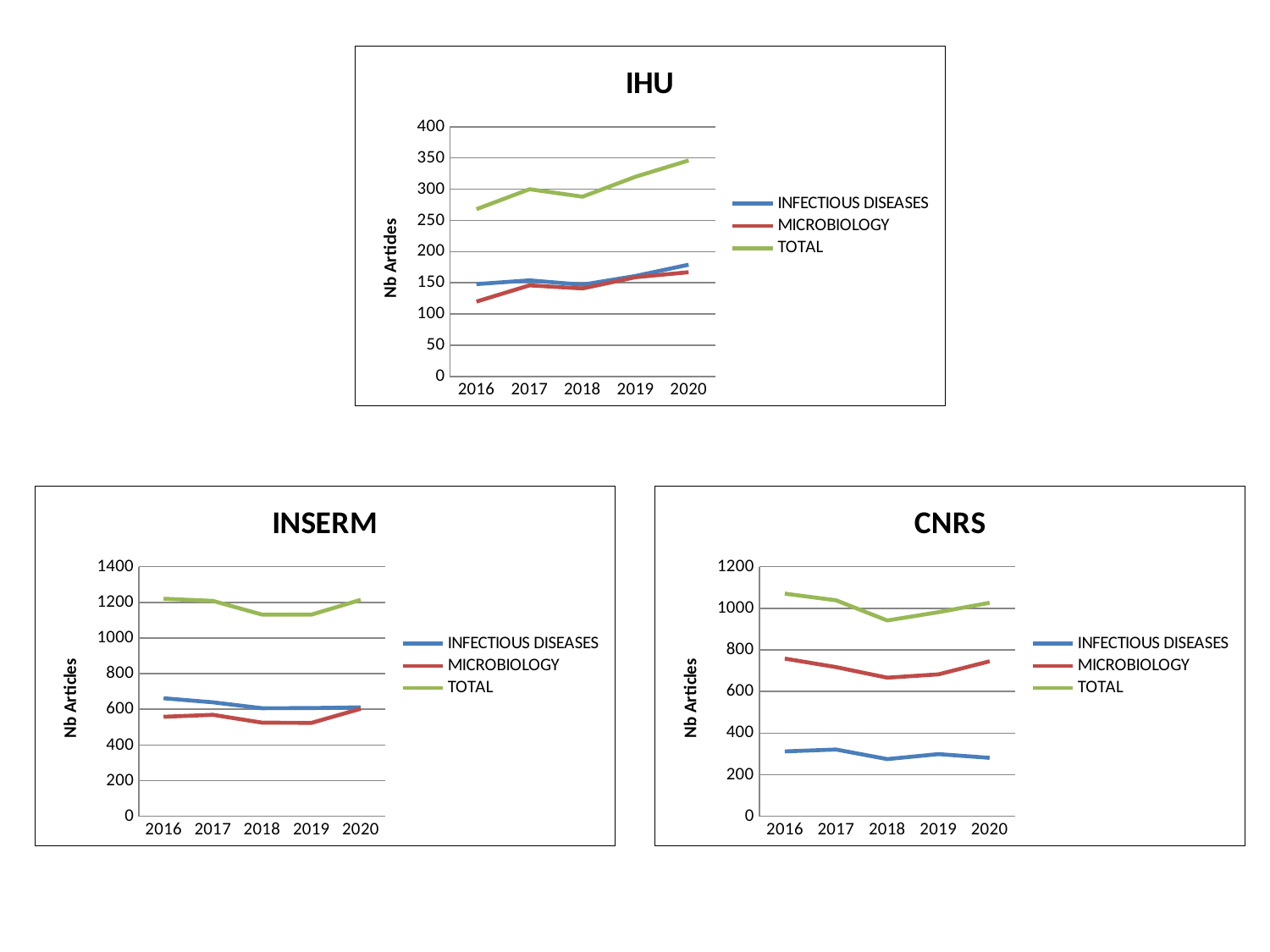
In the CNRS chart, is the TOTAL value for 2018 greater or less than 1000? less In the CNRS chart, which year has the lowest TOTAL value? 2018 In the INSERM chart, which series is larger in 2016, INFECTIOUS DISEASES or MICROBIOLOGY? INFECTIOUS DISEASES In the IHU chart, is the MICROBIOLOGY value for 2016 greater or less than 150? less How many years are plotted on the x axis of the CNRS chart? 5 In the IHU chart, which year has the highest TOTAL value? 2020 In the IHU chart, is the TOTAL value for 2020 greater or less than 300? greater What is the y-axis label of the CNRS chart? Nb Articles In the IHU chart, does the TOTAL series overall rise or fall from 2016 to 2020? rise How many series does the legend of the INSERM chart list? 3 What kind of chart is the IHU chart? line chart